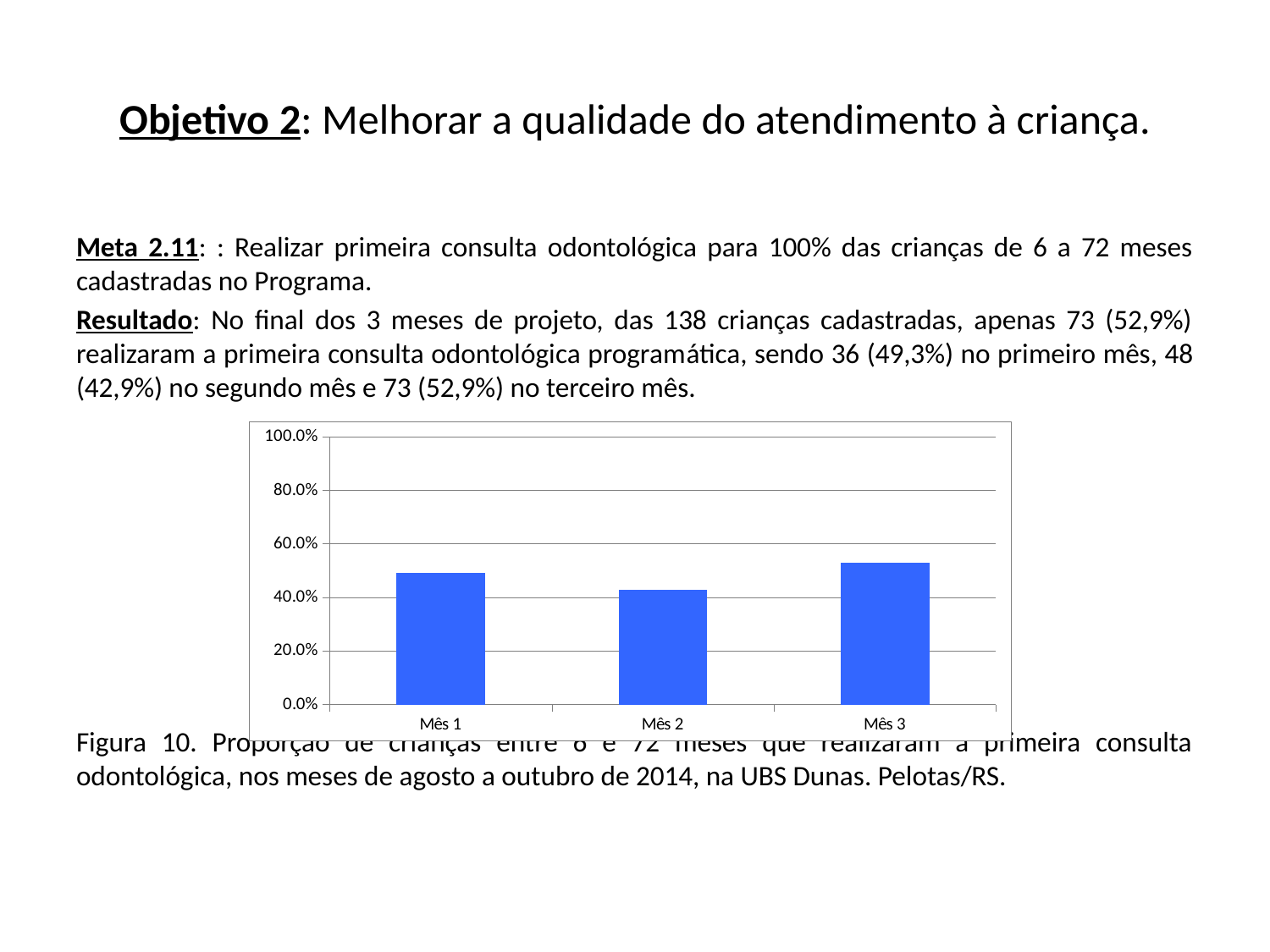
Is the value for Mês 1 greater or less than 20.0%? greater What is the label of the first category on the x axis of the chart? Mês 1 Which month has the lowest bar in the chart? Mês 2 Which is larger in the chart, the value for Mês 1 or the value for Mês 2? Mês 1 What is the highest value shown on the chart's vertical axis? 100.0% Is the value for Mês 1 greater or less than 60.0%? less Is the value for Mês 2 greater or less than 60.0%? less How many months (categories) are plotted in the chart? 3 Do the values rise steadily from Mês 1 to Mês 3? No, they fall from Mês 1 to Mês 2 and then rise in Mês 3 What kind of chart is shown on the slide? bar chart Which month has the highest bar in the chart? Mês 3